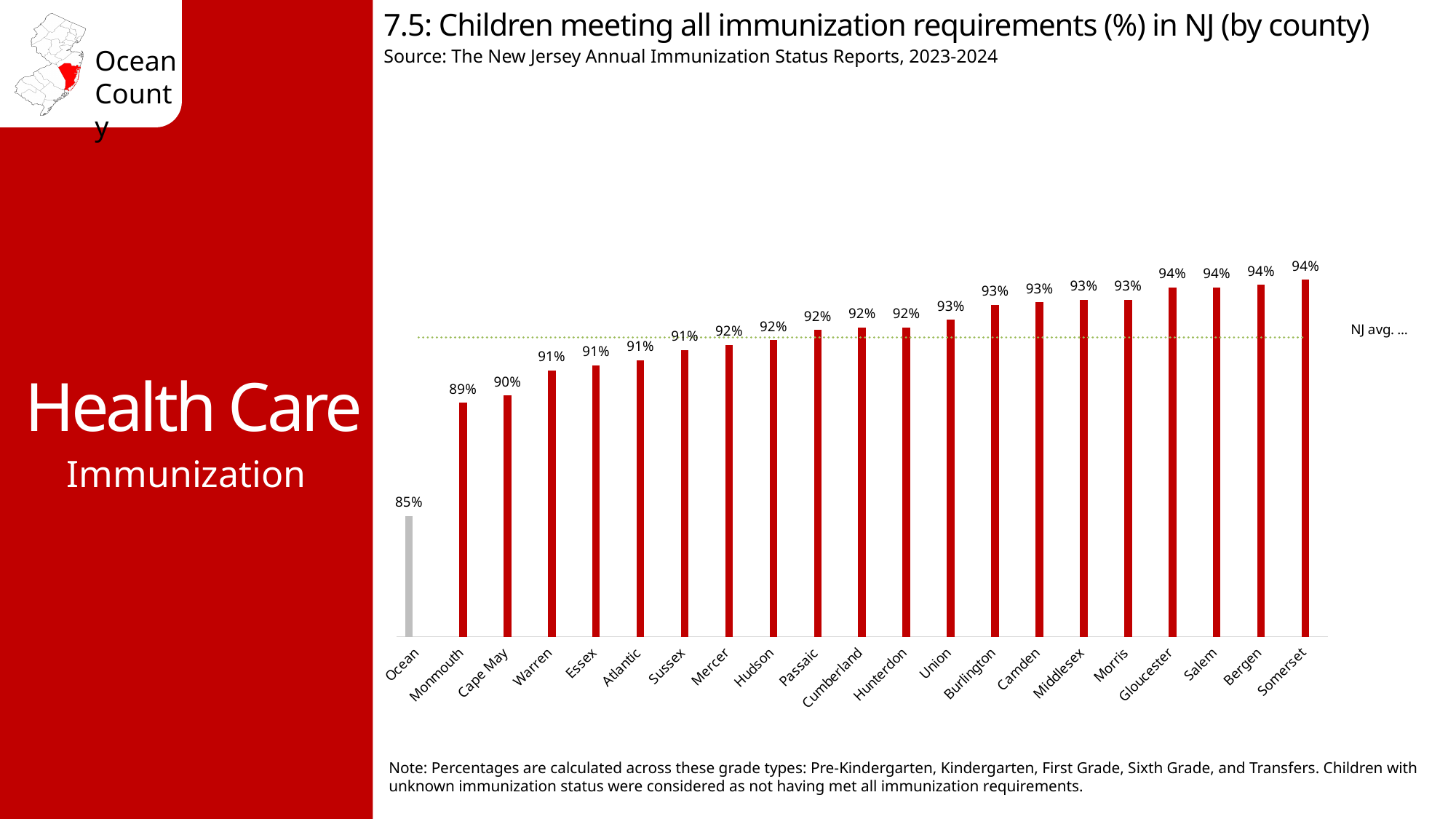
Which has a higher value, Ocean or Cape May? Cape May What is the difference in percentage points between Somerset and Ocean? 9 percentage points What is the value shown for Union County? 93% Which county has the lowest percentage of children meeting all immunization requirements? Ocean What is the value shown for Monmouth County? 89% Do the values generally rise or fall from left to right across the counties? Rise What is the value shown for Somerset County? 94% How many counties are shown on the chart? 21 What percentage of children in Ocean County meet all immunization requirements? 85% What kind of chart is shown on the slide? Bar chart What is the difference in percentage points between Monmouth and Ocean? 4 percentage points What is the value shown for Cape May County? 90%